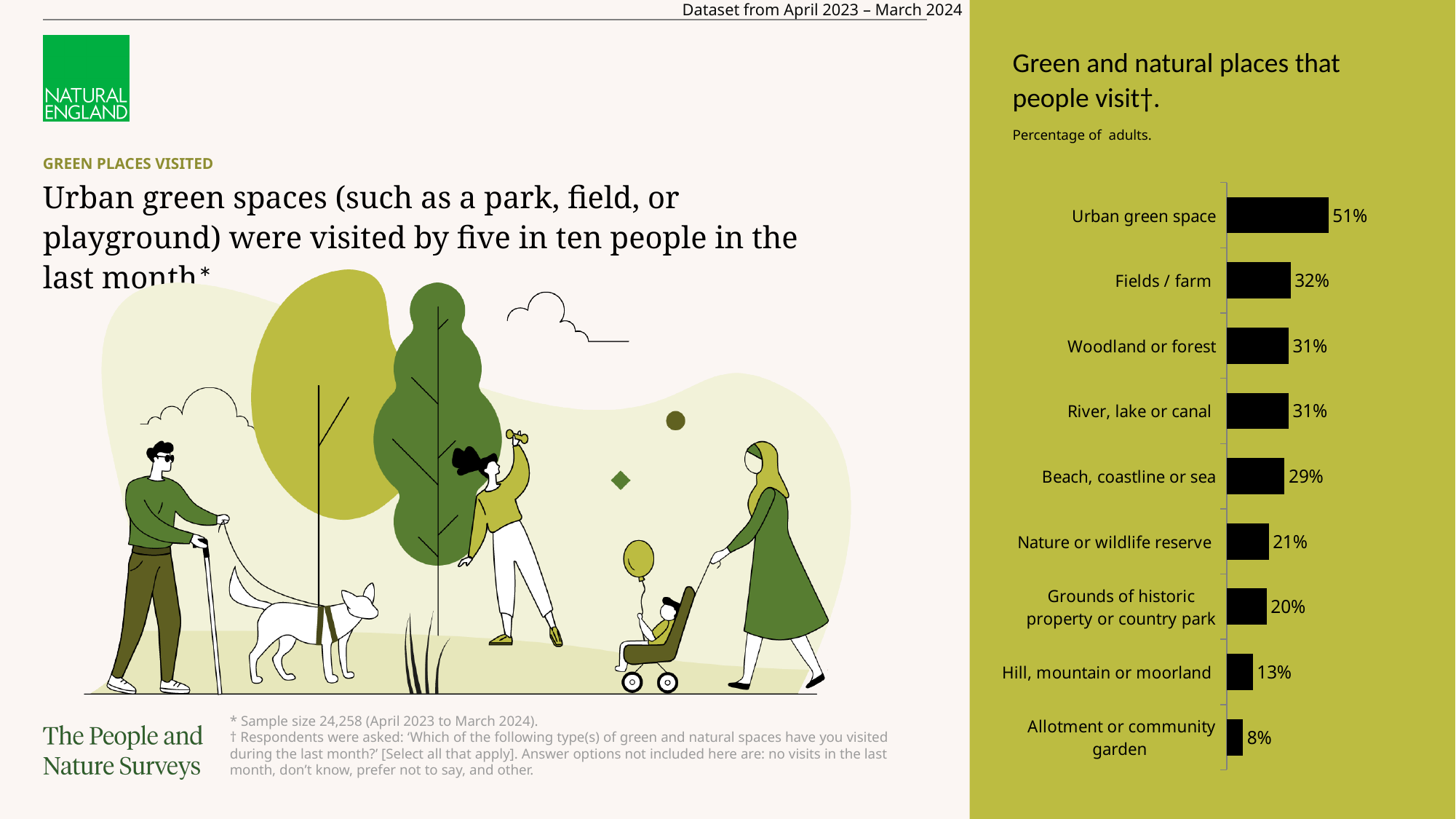
What is the difference in percentage points between Nature or wildlife reserve and Allotment or community garden? 13 What percentage of adults visited a hill, mountain or moorland? 13% What percentage of adults visited a beach, coastline or sea? 29% How many categories are shown in the chart? 9 Which two categories both have a value of 31%? Woodland or forest; River, lake or canal What percentage of adults visited an urban green space? 51% What is the difference in percentage points between Urban green space and Fields / farm? 19 What kind of chart is shown on the slide? Bar chart Which category has the highest percentage of adults? Urban green space What is the title of the chart? Green and natural places that people visit†. Which category has the lowest percentage of adults? Allotment or community garden Which has a higher percentage: Fields / farm or Beach, coastline or sea? Fields / farm